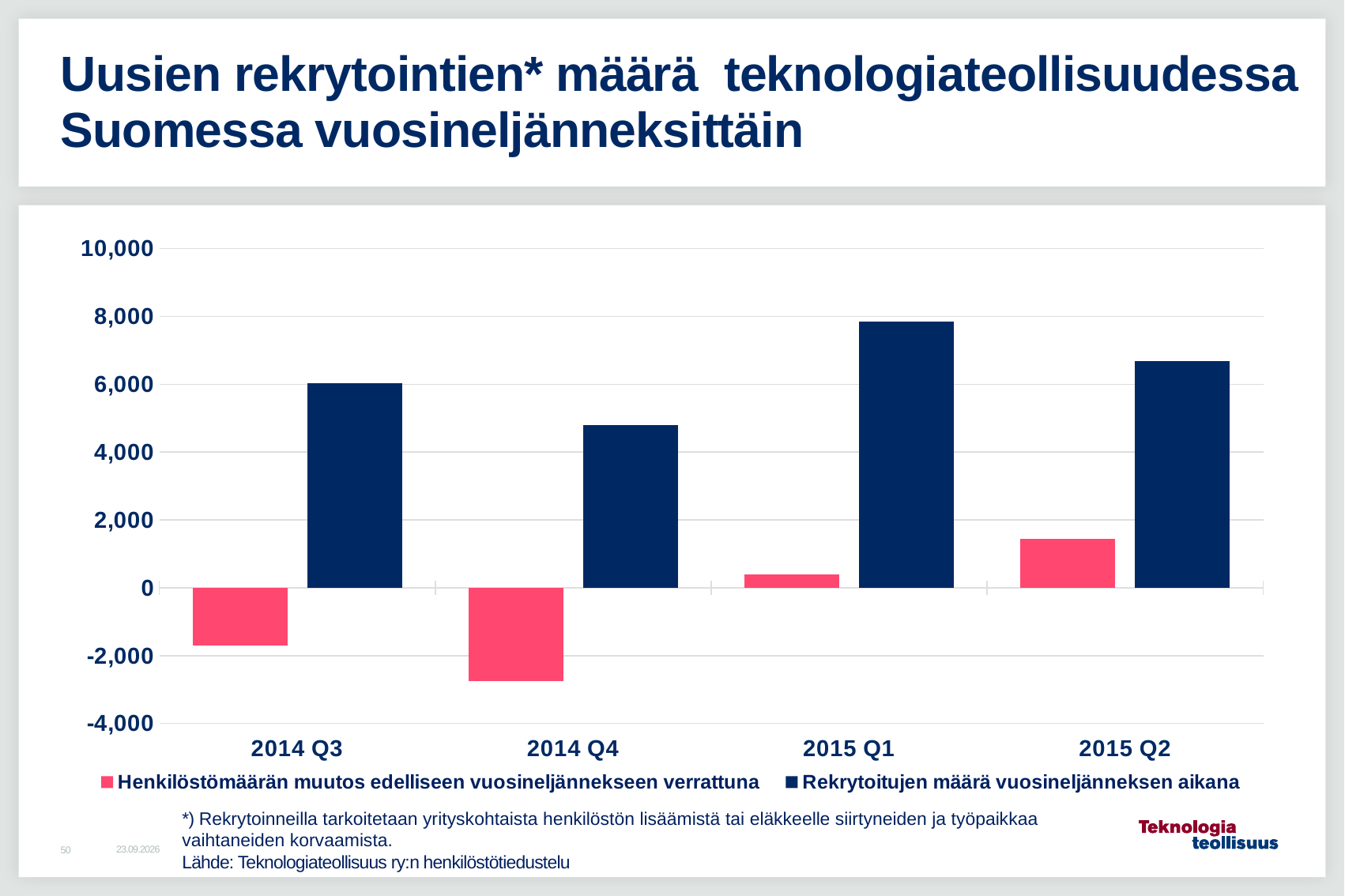
Is the value for 'Henkilöstömäärän muutos edelliseen vuosineljännekseen verrattuna' in 2014 Q4 greater or less than -2,000? less How many series does the legend list? 2 In which quarter is the value for 'Henkilöstömäärän muutos edelliseen vuosineljännekseen verrattuna' highest? 2015 Q2 In which quarter is the value for 'Henkilöstömäärän muutos edelliseen vuosineljännekseen verrattuna' lowest? 2014 Q4 In which quarter is the value for 'Rekrytoitujen määrä vuosineljänneksen aikana' highest? 2015 Q1 Is the value for 'Rekrytoitujen määrä vuosineljänneksen aikana' in 2015 Q1 greater or less than 6,000? greater How many quarters are shown on the x axis? 4 Which colour represents 'Rekrytoitujen määrä vuosineljänneksen aikana' in the chart? Dark blue In which quarter is the value for 'Rekrytoitujen määrä vuosineljänneksen aikana' lowest? 2014 Q4 What kind of chart is shown on the slide? Bar chart Is the value for 'Rekrytoitujen määrä vuosineljänneksen aikana' in 2014 Q4 greater or less than 6,000? less Which is larger: the value for 'Rekrytoitujen määrä vuosineljänneksen aikana' in 2015 Q1 or in 2015 Q2? 2015 Q1